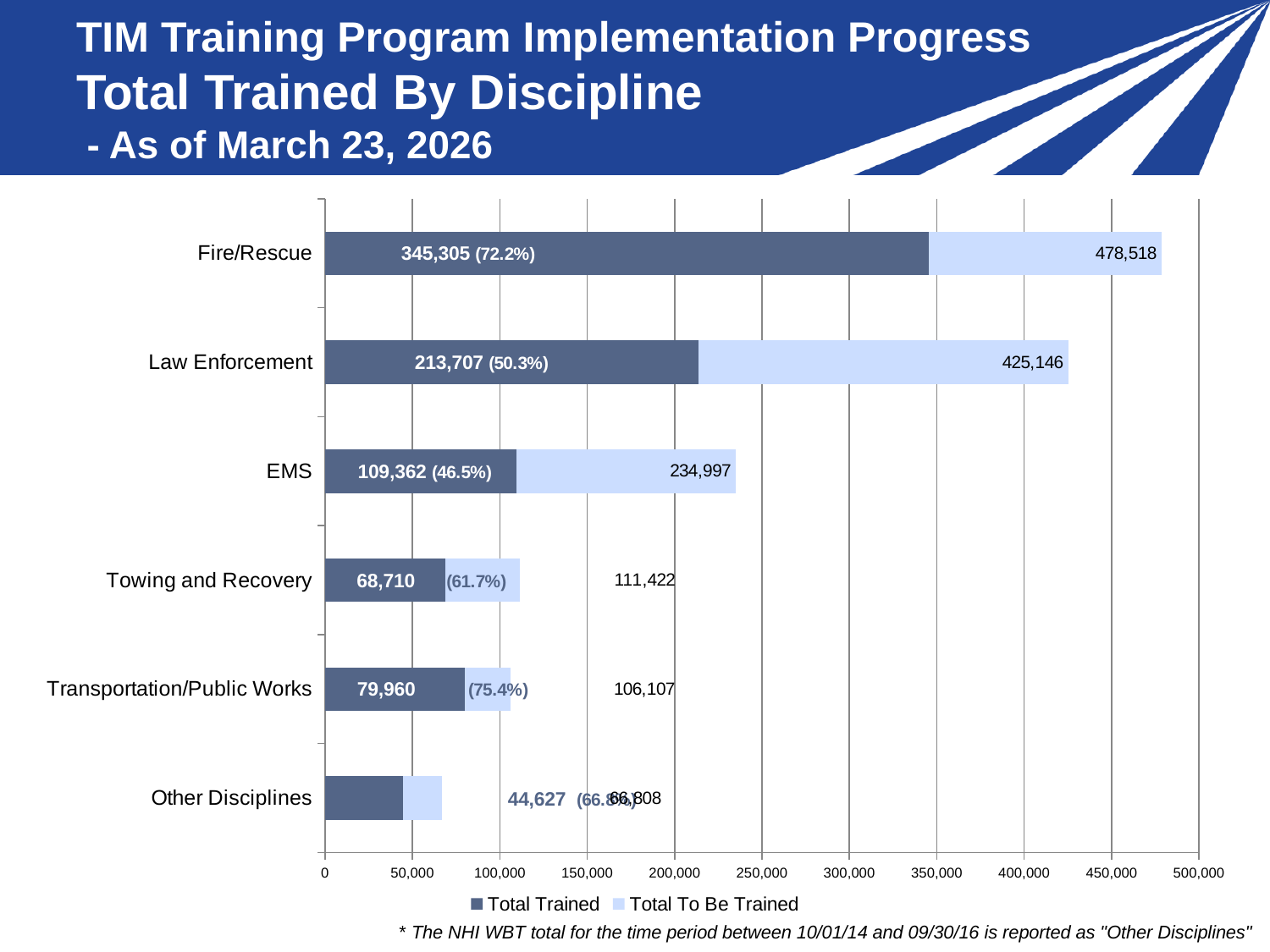
What is the Total To Be Trained value for Towing and Recovery? 111,422 What is the Total To Be Trained value for Law Enforcement? 425,146 What percentage of the EMS total has been trained, according to the data label? 46.5% How many series does the legend list? 2 What is the difference between the Total To Be Trained and the Total Trained for Fire/Rescue? 133,213 How many disciplines are shown on the chart? 6 Which has a larger Total Trained value: Towing and Recovery or Transportation/Public Works? Transportation/Public Works How many trained personnel does the chart show for Fire/Rescue? 345,305 Which discipline has the highest Total Trained value? Fire/Rescue What kind of chart is shown on the slide? Bar chart Which discipline has the lowest Total To Be Trained value? Other Disciplines